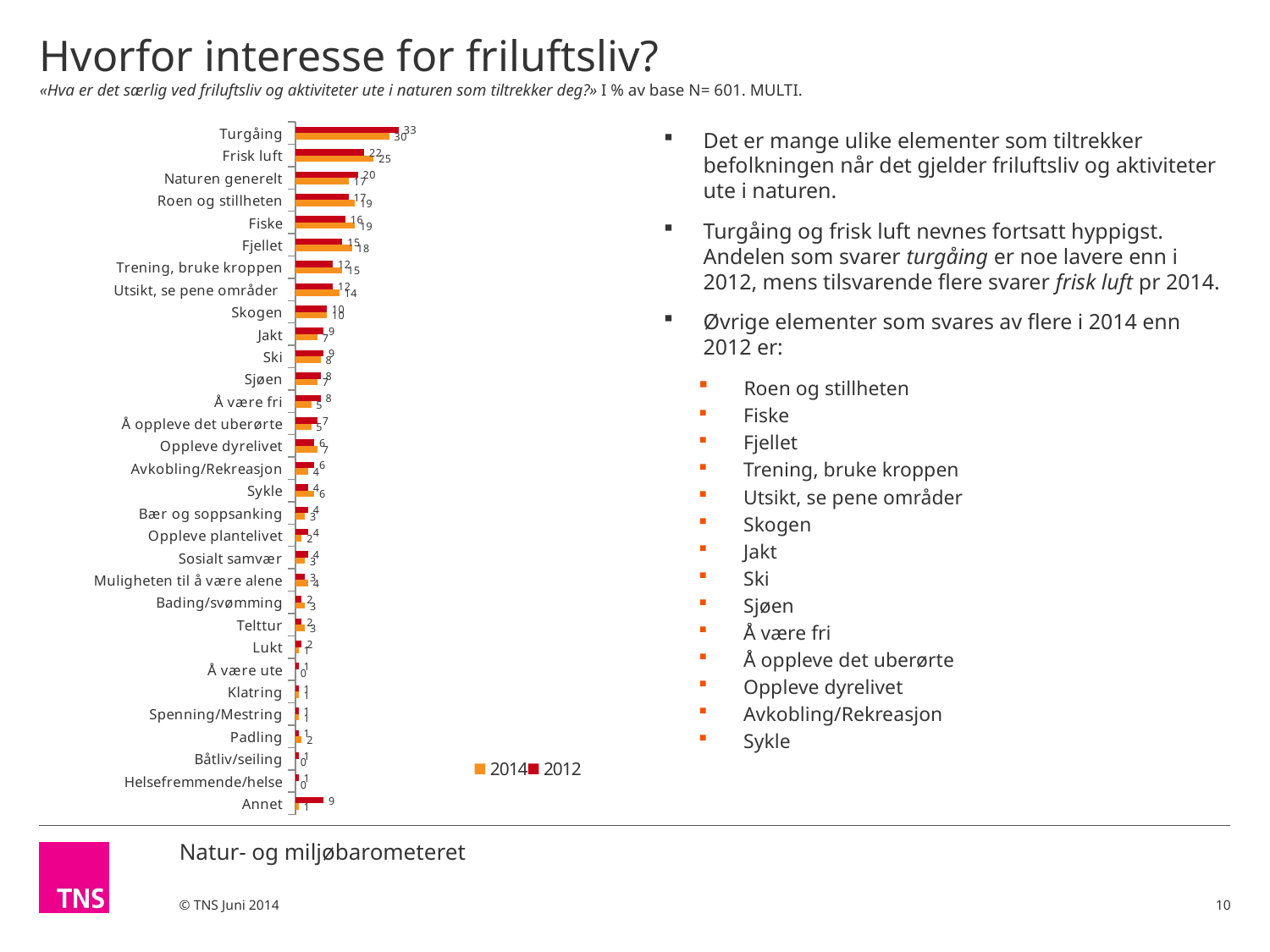
Which category has the highest value in the chart? Turgåing What is the value for Frisk luft in the 2014 series? 25 What is the value for Turgåing in the 2012 series? 33 What is the value for Annet in the 2012 series? 9 What kind of chart is shown on the slide? Bar chart For Turgåing, which series has the larger value, 2014 or 2012? 2012 What is the value for Turgåing in the 2014 series? 30 For Frisk luft, which series has the larger value, 2014 or 2012? 2014 Which colour represents the 2012 series in the chart? Red What is the difference between the 2012 and 2014 values for Turgåing? 3 How many categories are shown in the chart? 31 How many series does the legend list? 2